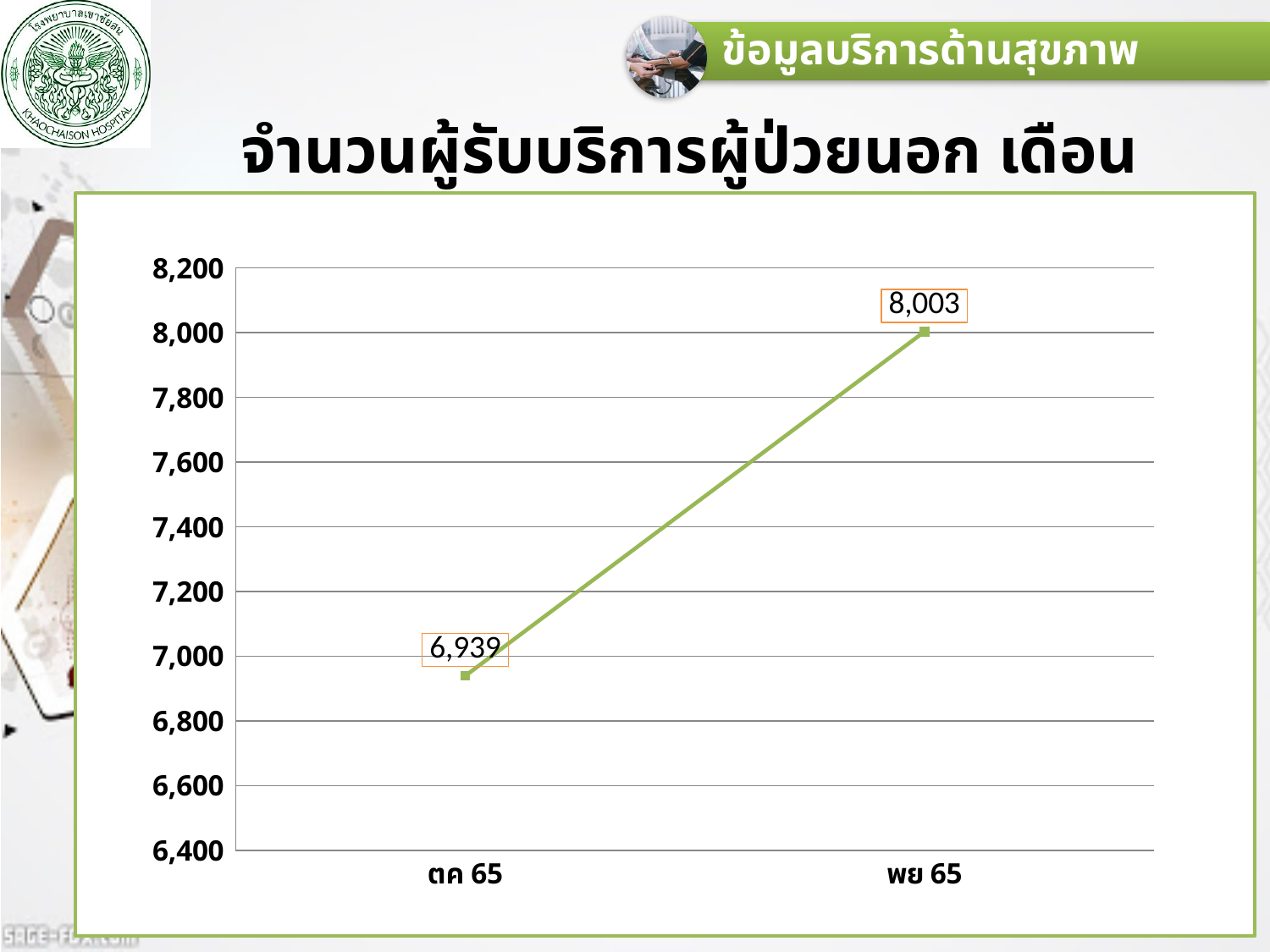
Is the value for ตค 65 greater or less than 7,000? less What is the value for พย 65? 8,003 Which month has the lowest value? ตค 65 What kind of chart is shown on the slide? line chart Is the value for พย 65 greater or less than 8,000? greater How many months are plotted on the chart? 2 What is the lowest value shown on the vertical axis? 6,400 Which month has the highest value? พย 65 What is the value for ตค 65? 6,939 Which is larger, the value for ตค 65 or the value for พย 65? พย 65 Do the values rise or fall from ตค 65 to พย 65? rise What is the difference between the values for พย 65 and ตค 65? 1,064